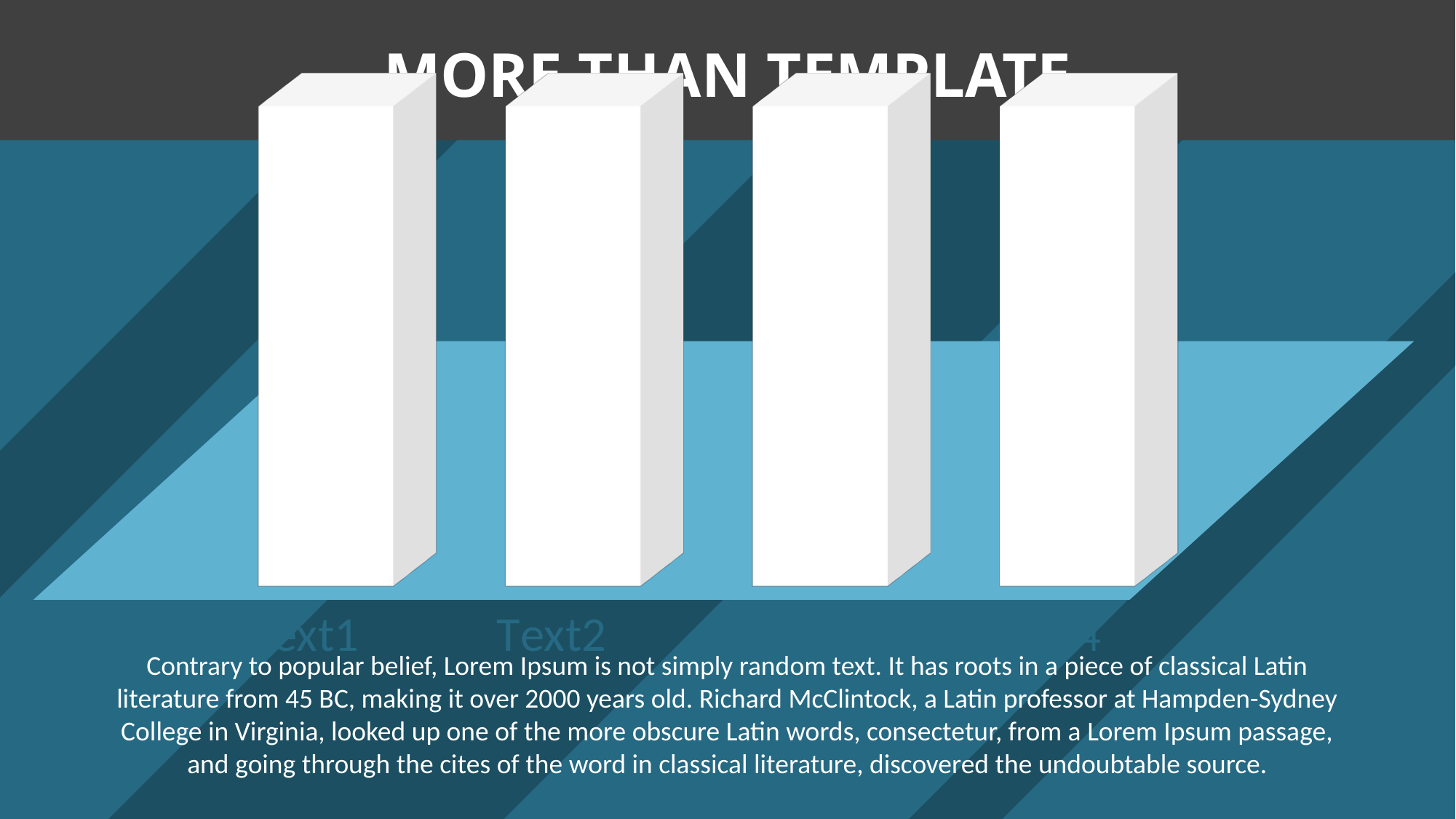
What is the category label under the second bar? Text2 What is the title shown at the top of the slide? MORE THAN TEMPLATE What kind of chart is shown on the slide? bar chart What colour are the bars in the chart? white How many bars does the chart show? 4